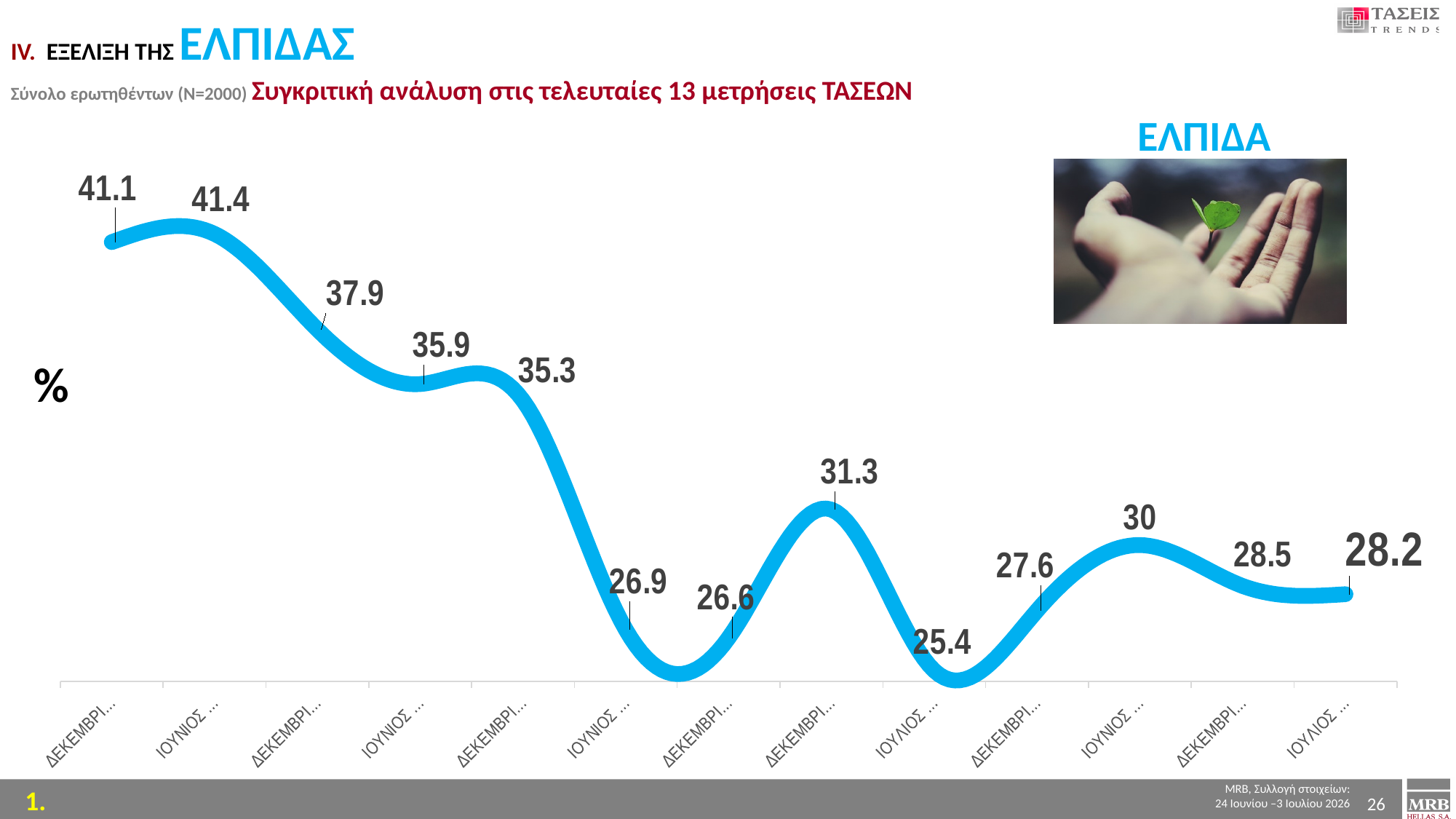
What kind of chart is shown on the slide? line chart What is the value of the eighth point on the line chart, the peak between 26.6 and 25.4? 31.3 What is the difference between the highest value (41.4) and the lowest value (25.4) on the line chart? 16 What is the value of the last (rightmost) point on the line chart? 28.2 Overall, do the values on the line chart rise or fall from left to right? fall Which is larger on the line chart: the value 31.3 or the value 27.6? 31.3 What is the difference between the first point (41.1) and the last point (28.2) on the line chart? 12.9 What is the value of the first (leftmost) point on the line chart? 41.1 How many data points are plotted on the line chart? 13 What is the highest value shown on the line chart? 41.4 What is the lowest value shown on the line chart? 25.4 What word appears in blue above the photo on the right side of the slide? ΕΛΠΙΔΑ